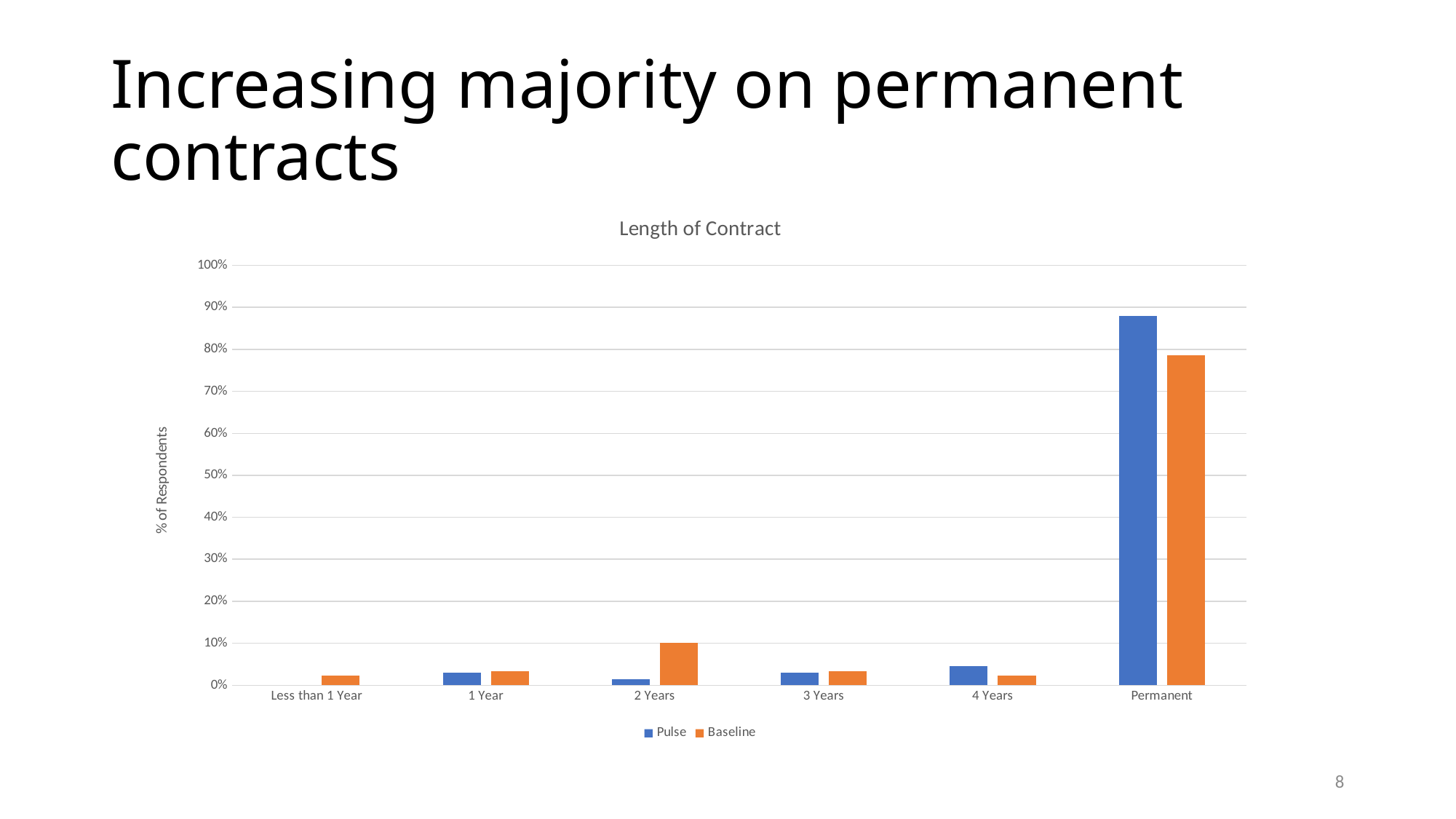
What kind of chart is shown on the slide? Bar chart What is the label on the vertical axis? % of Respondents Is the Pulse value for Permanent greater or less than 80%? greater How many contract-length categories are shown on the x axis? 6 Which category has the highest Baseline value? Permanent Is the Baseline value for Permanent greater or less than 70%? greater For 4 Years, which series has the larger value, Pulse or Baseline? Pulse For Permanent, which series has the larger value, Pulse or Baseline? Pulse How many series does the legend list? 2 Which category has the highest Pulse value? Permanent For 2 Years, which series has the larger value, Pulse or Baseline? Baseline What is the title of the chart? Length of Contract